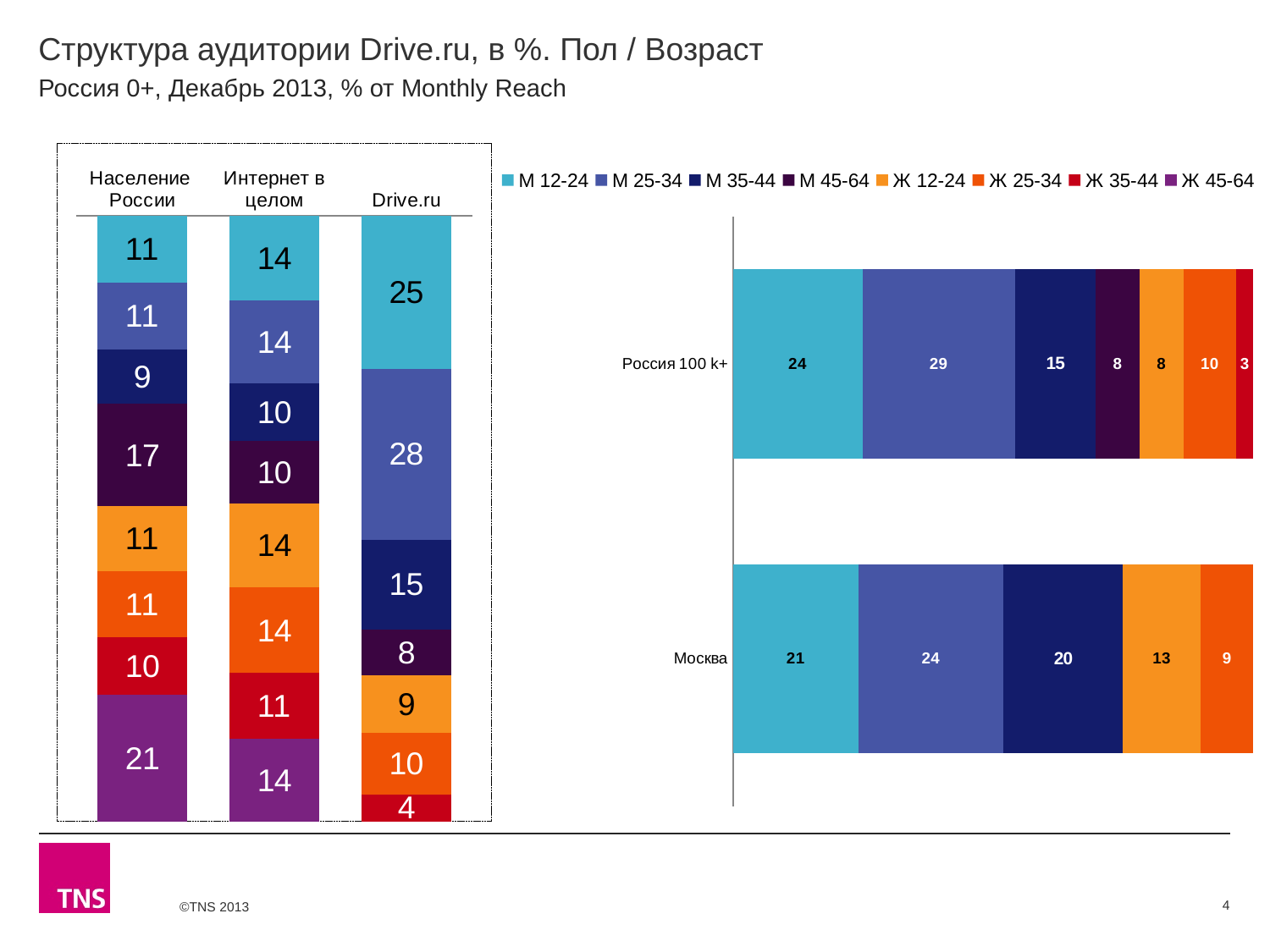
In the left chart, what is the value of the М 25-34 segment for Drive.ru? 28 In the left chart, what is the value of the М 45-64 segment for Интернет в целом? 10 In the right chart, what is the value of the М 25-34 segment for Россия 100 k+? 29 In the left chart, which segment of the Drive.ru bar is the smallest? Ж 35-44 In the left chart, which segment of the Drive.ru bar is the largest? М 25-34 In the right chart, what is the value of the М 35-44 segment for Москва? 20 In the right chart, which is larger: the М 12-24 value for Россия 100 k+ or for Москва? Россия 100 k+ In the left chart, what is the value of the Ж 45-64 segment for Население России? 21 How many series does the legend list? 8 How many categories are shown in the right chart? 2 What type of chart is the right chart? Stacked bar chart In the left chart, what is the difference between the М 12-24 values for Drive.ru and Население России? 14